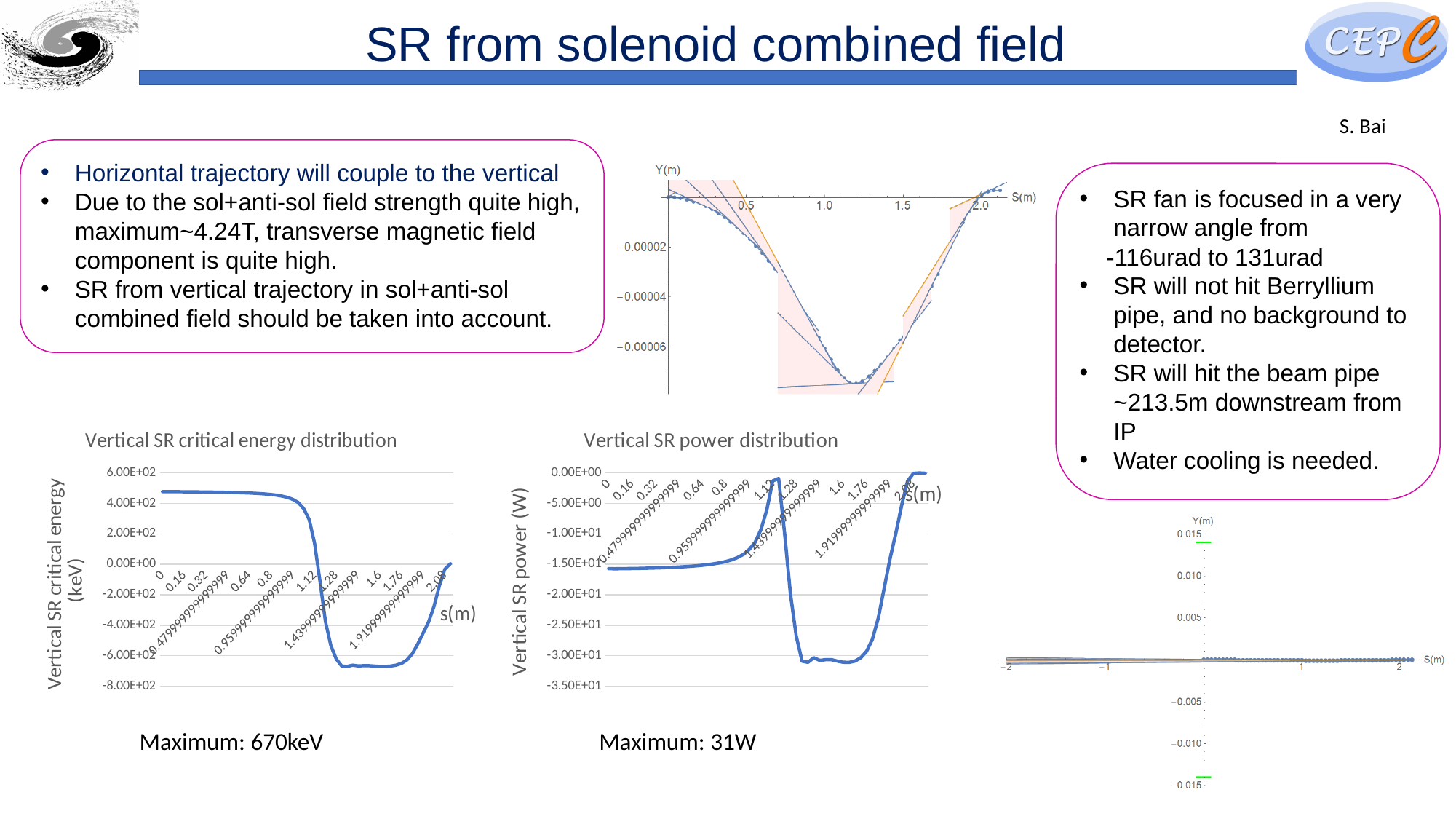
What kind of chart is the 'Vertical SR critical energy distribution' chart? line chart In the 'Vertical SR power distribution' chart, does the value rise or fall between s = 0 and s = 1.12? rise In the 'Vertical SR power distribution' chart, does the value rise or fall between s = 1.76 and s = 2.08? rise What maximum value is stated below the 'Vertical SR power distribution' chart? 31W What is the title of the chart on the lower left of the slide? Vertical SR critical energy distribution In the 'Vertical SR critical energy distribution' chart, is the value at s = 0 greater or less than 4.00E+02? greater In the 'Vertical SR critical energy distribution' chart, does the value rise or fall between s = 1.12 and s = 1.28? fall In the 'Vertical SR power distribution' chart, is the value at s = 1.6 greater or less than -2.50E+01? less In the 'Vertical SR critical energy distribution' chart, which is larger: the value at s = 0 or the value at s = 1.6? s = 0 In the 'Vertical SR critical energy distribution' chart, is the value at s = 1.6 greater or less than -6.00E+02? less In the 'Vertical SR power distribution' chart, which is larger: the value at s = 1.12 or the value at s = 1.6? s = 1.12